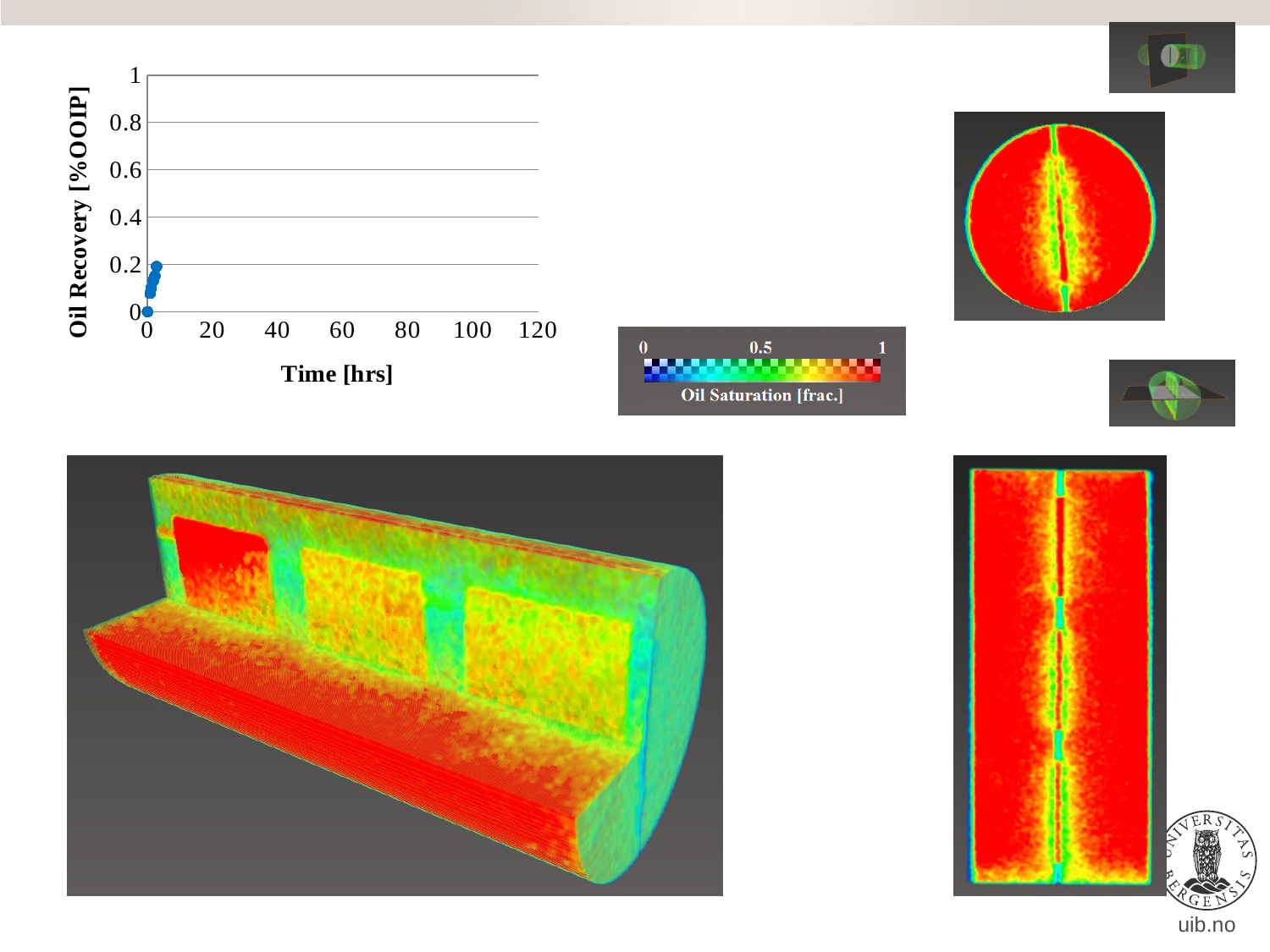
Are all the plotted points at times greater or less than 20 hrs? less What kind of chart is shown on the slide? scatter chart Is the highest plotted oil recovery value greater or less than 0.6? less What is the title of the x axis of the chart? Time [hrs] Is the highest plotted oil recovery value greater or less than 0.4? less What is the largest tick value shown on the x axis of the chart? 120 What is the title of the y axis of the chart? Oil Recovery [%OOIP] Do the oil recovery values rise or fall as time increases along the x axis? rise